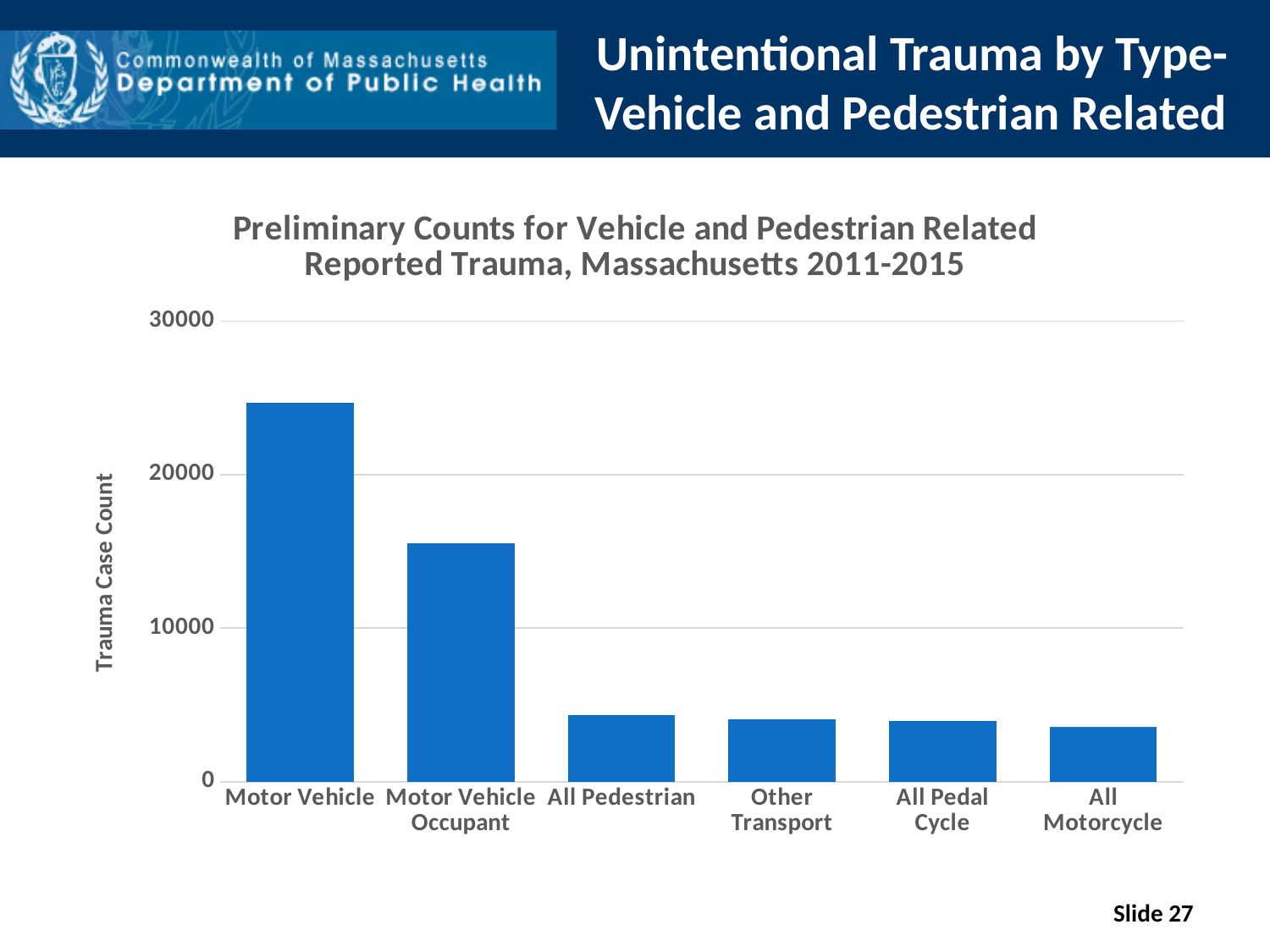
Which is larger, the value for Motor Vehicle or the value for Motor Vehicle Occupant? Motor Vehicle Is the value for Motor Vehicle Occupant greater or less than 10000? greater Is the value for All Pedestrian greater or less than 10000? less Is the value for All Motorcycle greater or less than 10000? less Do the values rise or fall moving from left to right along the x axis? fall What is the label on the y axis of the chart? Trauma Case Count Which is larger, the value for All Pedestrian or the value for All Motorcycle? All Pedestrian How many categories are shown on the x axis of the chart? 6 Which category has the highest trauma case count? Motor Vehicle What kind of chart is shown on the slide? bar chart